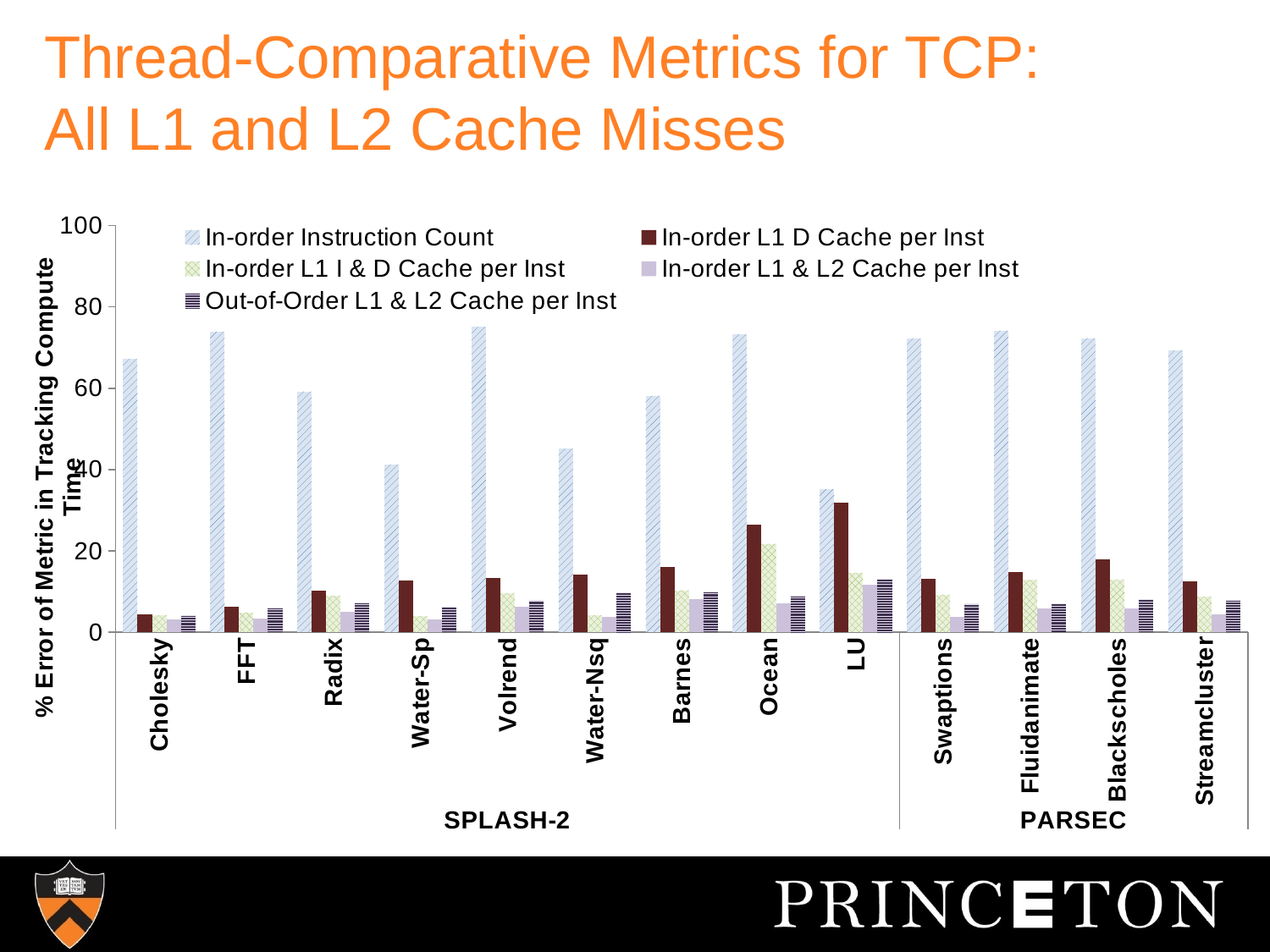
What is the label of the y axis? % Error of Metric in Tracking Compute Time Is the In-order L1 D Cache per Inst value for Ocean greater or less than 20? greater How many benchmark categories are plotted along the x axis? 13 Is the In-order Instruction Count value for LU greater or less than 40? less How many series does the legend list? 5 Is the In-order Instruction Count value for Cholesky greater or less than 60? greater Which benchmark has the lowest In-order Instruction Count value? LU How many benchmarks are in the PARSEC group? 4 What kind of chart is shown on the slide? bar chart Which benchmark has the highest In-order L1 D Cache per Inst value? LU Which is larger, the In-order Instruction Count value for Ocean or for LU? Ocean Which is larger, the In-order L1 D Cache per Inst value for LU or for Ocean? LU